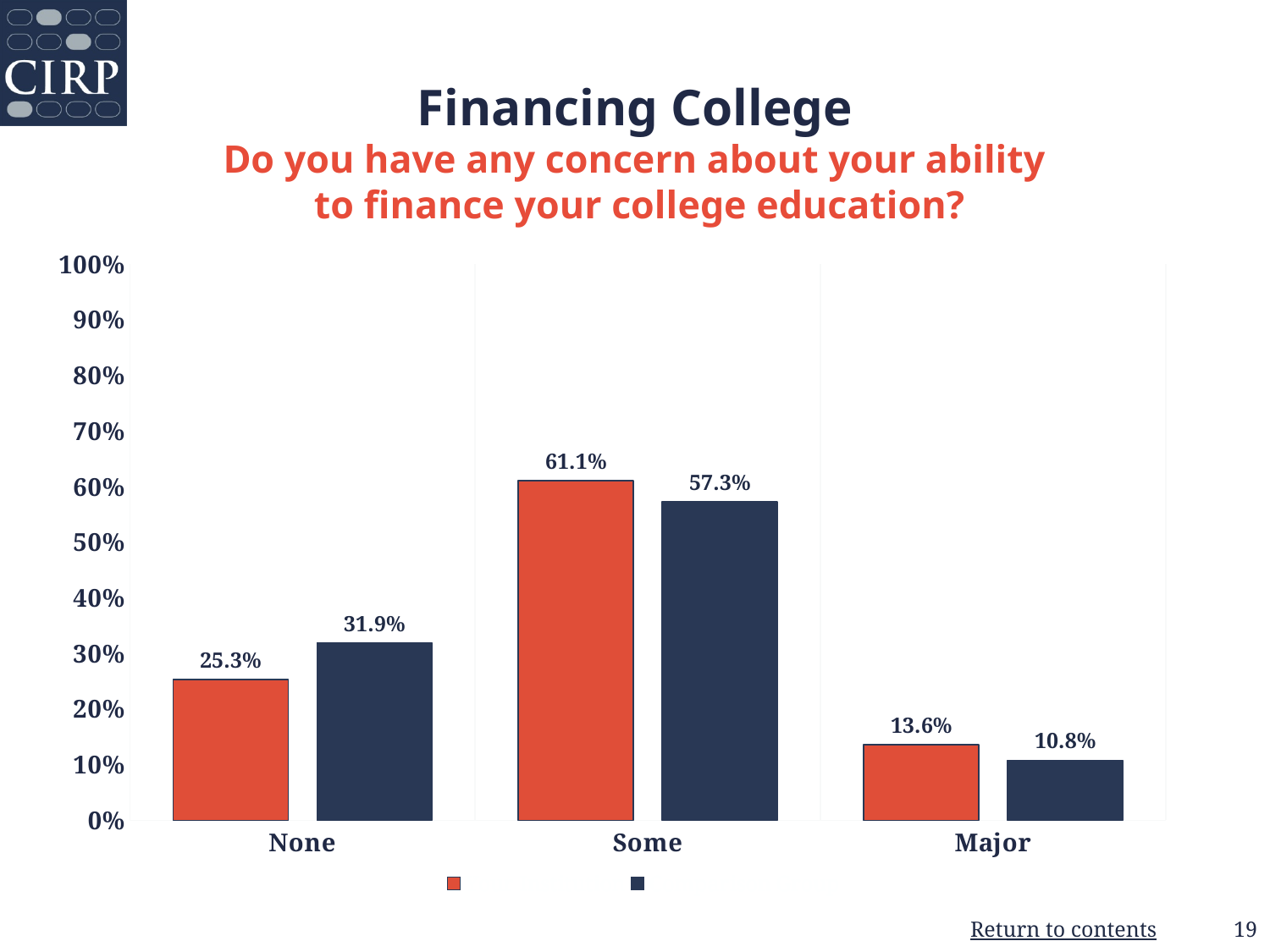
Is the dark blue bar for "Some" greater or less than 50%? greater What kind of chart is shown on the slide? bar chart What is the value of the dark blue bar for the "Major" category? 10.8% What is the value of the orange bar for the "Major" category? 13.6% Which category has the lowest dark blue bar? Major What is the value of the orange bar for the "Some" category? 61.1% What is the title of the slide containing the chart? Financing College What is the value of the dark blue bar for the "None" category? 31.9% What is the difference between the orange and dark blue bars for the "Some" category? 3.8% Which category has the highest orange bar? Some How many categories are shown on the x axis? 3 For the "None" category, which bar is larger, the orange or the dark blue? dark blue